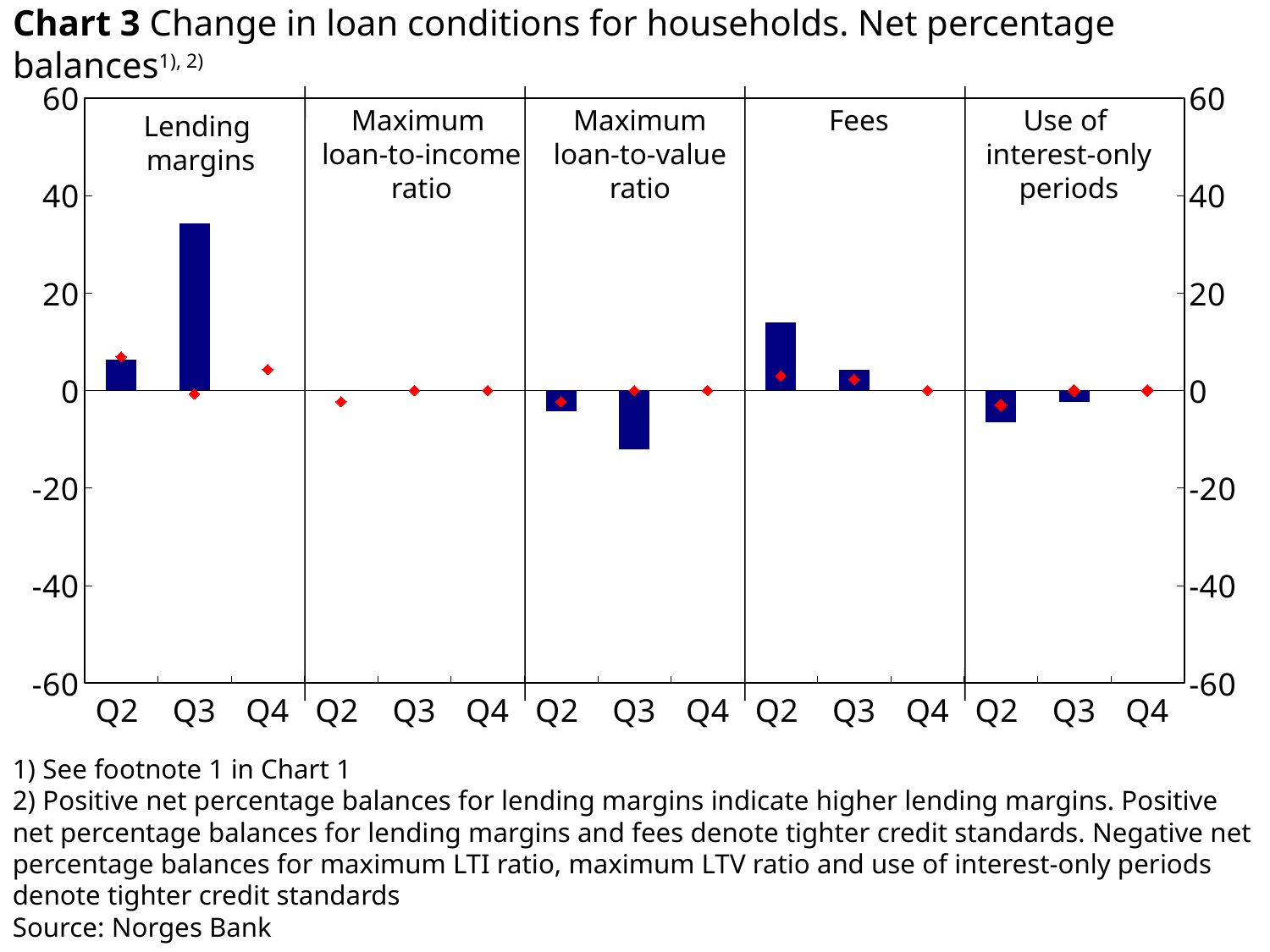
For Fees, which quarter has the larger bar, Q2 or Q3? Q2 Is the Q2 bar for Fees greater or less than 20? less Which panel and quarter has the tallest bar in the chart? Lending margins, Q3 Do the Fees bars rise or fall from Q2 to Q4? fall Is the Q3 bar for Maximum loan-to-value ratio greater or less than 0? less Which panel and quarter has the lowest (most negative) bar in the chart? Maximum loan-to-value ratio, Q3 For Lending margins, which quarter has the larger bar, Q2 or Q3? Q3 Is the Q3 bar for Lending margins greater or less than 20? greater How many loan condition panels are shown in the chart? 5 What is the source given for the chart? Norges Bank What kind of chart is Chart 3? bar chart